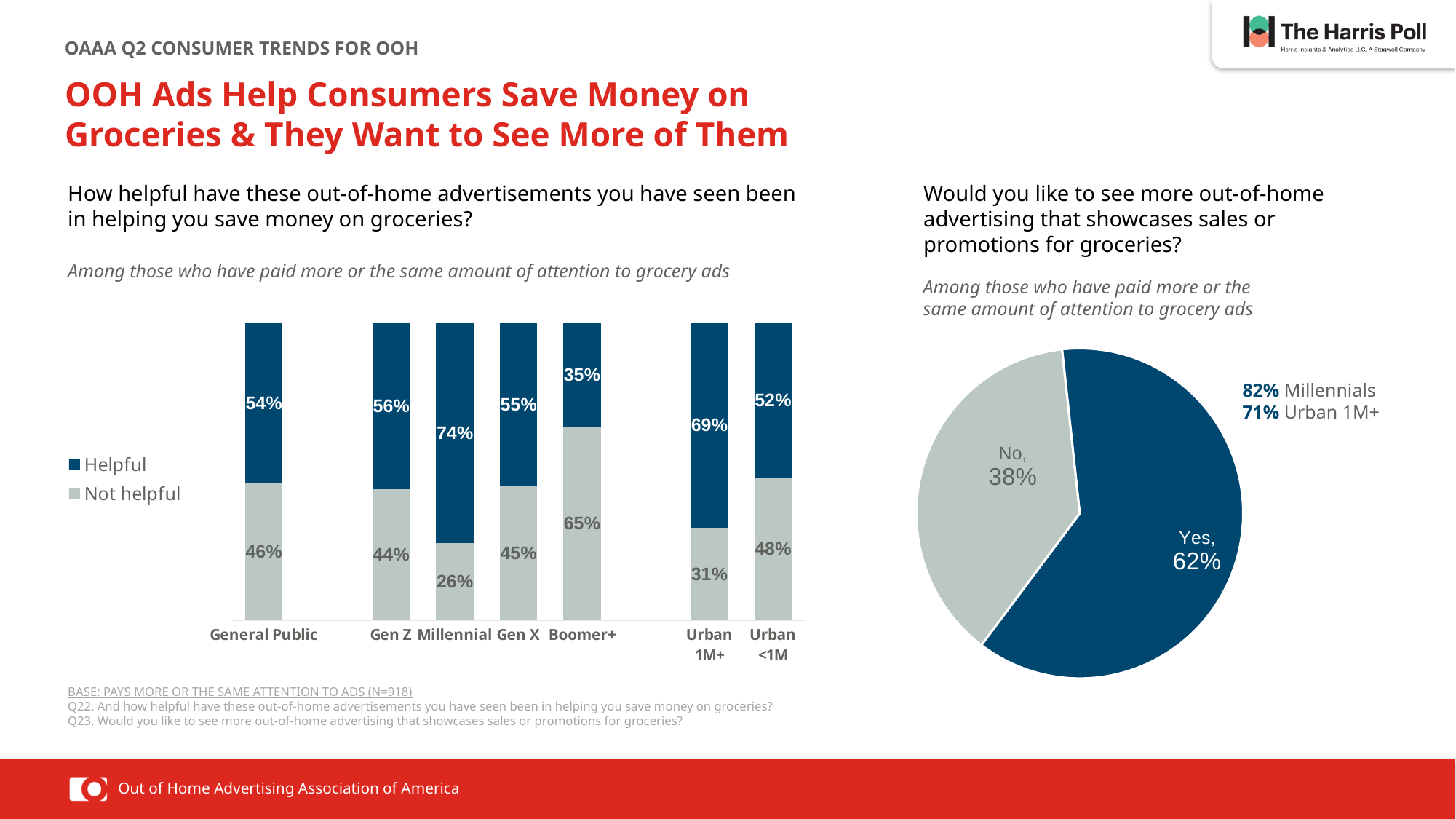
In the left stacked bar chart, what is the difference between the 'Helpful' values for Urban 1M+ and Urban <1M? 17% How many series does the legend of the left chart list? 2 In the left stacked bar chart, which category has the highest 'Helpful' percentage? Millennial In the left stacked bar chart, what percentage of Millennials said the ads were helpful? 74% In the pie chart on the right, what share of respondents answered 'Yes'? 62% How many categories are shown on the x axis of the left stacked bar chart? 7 What type of chart is on the right side of the slide? Pie chart In the left stacked bar chart, what is the 'Not helpful' value for Boomer+? 65% In the left stacked bar chart, which is larger: the 'Helpful' value for Gen Z or for Gen X? Gen Z In the left stacked bar chart, which category has the lowest 'Helpful' percentage? Boomer+ In the left stacked bar chart, what is the total of the 'Helpful' and 'Not helpful' values for General Public? 100% In the pie chart on the right, what is the difference between the 'Yes' and 'No' shares? 24%